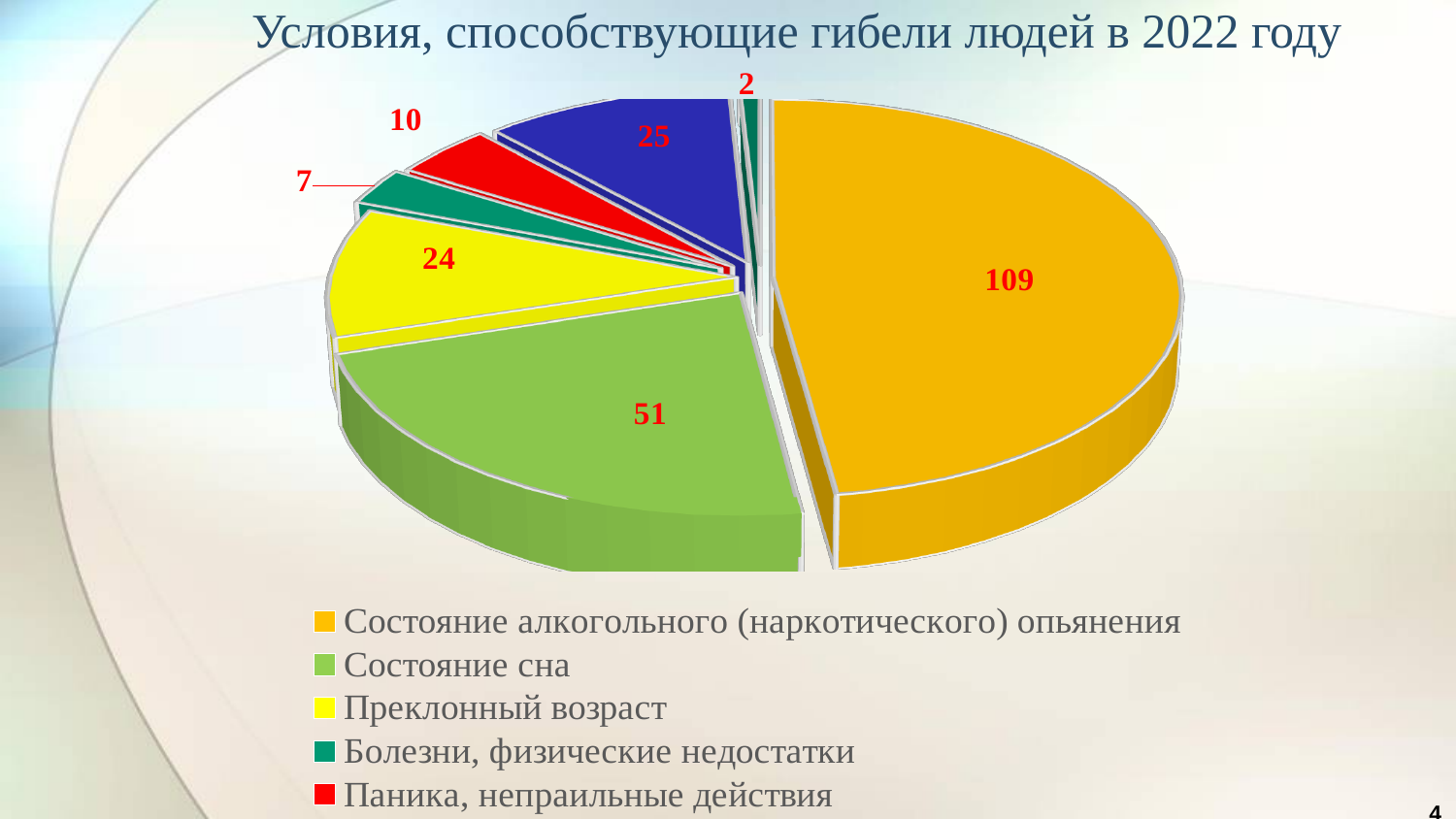
Which is larger: the value for «Преклонный возраст» or for «Паника, непраильные действия»? Преклонный возраст What is the difference between the values for «Паника, непраильные действия» and «Болезни, физические недостатки»? 3 What is the difference between the values for «Состояние алкогольного (наркотического) опьянения» and «Состояние сна»? 58 What is the value for «Состояние сна»? 51 What is the value for «Преклонный возраст»? 24 What is the value for «Болезни, физические недостатки»? 7 What is the value for «Паника, непраильные действия»? 10 Which category has the largest slice of the pie? Состояние алкогольного (наркотического) опьянения What is the title of the chart? Условия, способствующие гибели людей в 2022 году What kind of chart is shown on the slide? Pie chart What is the value for «Состояние алкогольного (наркотического) опьянения»? 109 How many slices does the pie chart have? 7